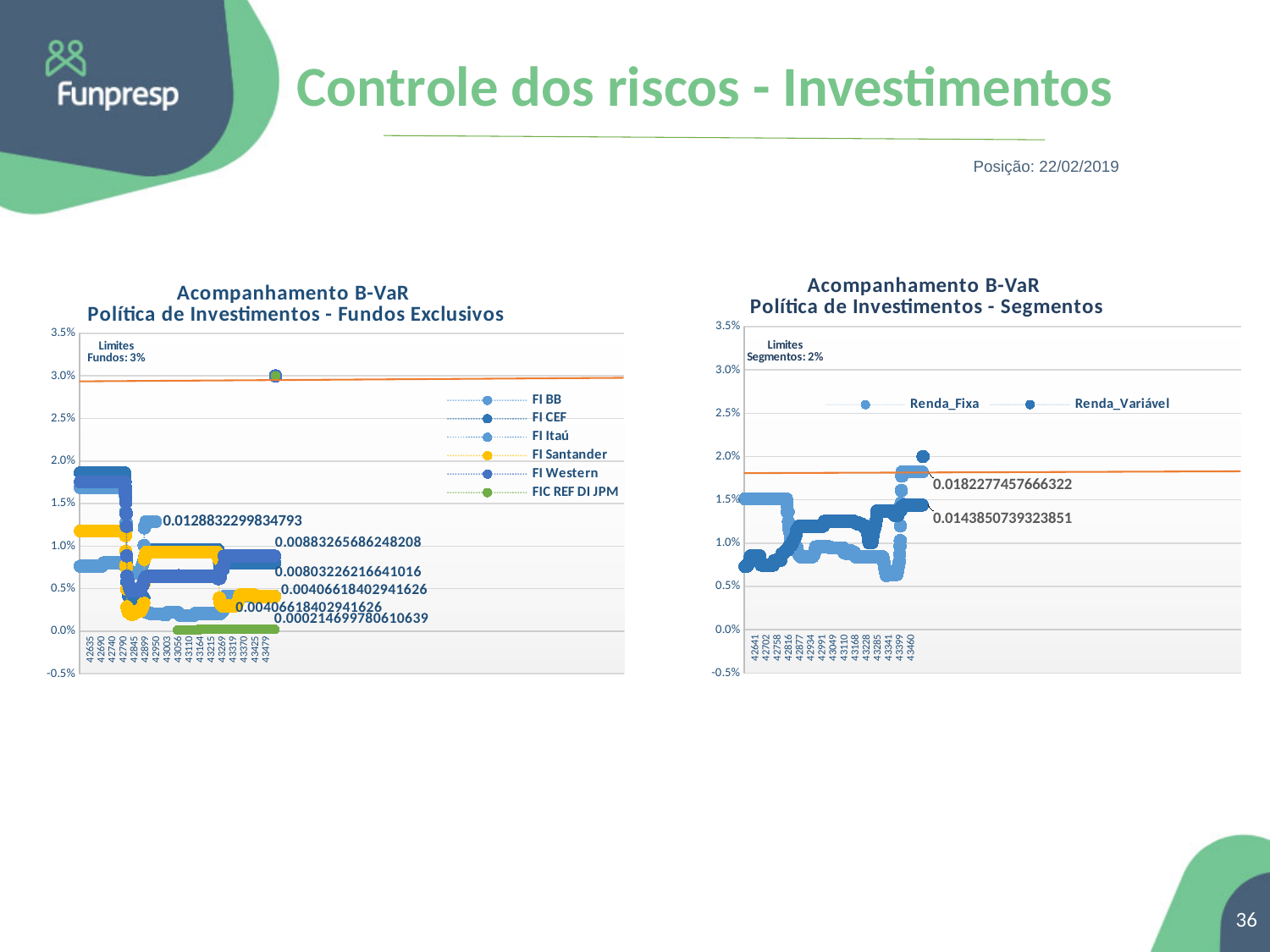
In the right chart (Segmentos), are the plotted values of both series greater or less than 2.5%? less What is the largest data label printed on the left chart (Fundos Exclusivos)? 0.0128832299834793 How many series does the legend of the right chart (Segmentos) list? 2 What is the title of the chart on the left? Acompanhamento B-VaR Política de Investimentos - Fundos Exclusivos What is the larger of the two data labels printed on the right chart (Segmentos)? 0.0182277457666322 What is the lowest value shown on the vertical axis of the left chart (Fundos Exclusivos)? -0.5% What is the highest value shown on the vertical axis of the right chart (Segmentos)? 3.5% How many series does the legend of the left chart (Fundos Exclusivos) list? 6 What is the smallest data label printed on the left chart (Fundos Exclusivos)? 0.000214699780610639 What limit is stated in the text box of the left chart (Fundos Exclusivos)? Limites Fundos: 3% What limit is stated in the text box of the right chart (Segmentos)? Limites Segmentos: 2% In the right chart (Segmentos), what are the two series named in the legend? Renda_Fixa and Renda_Variável